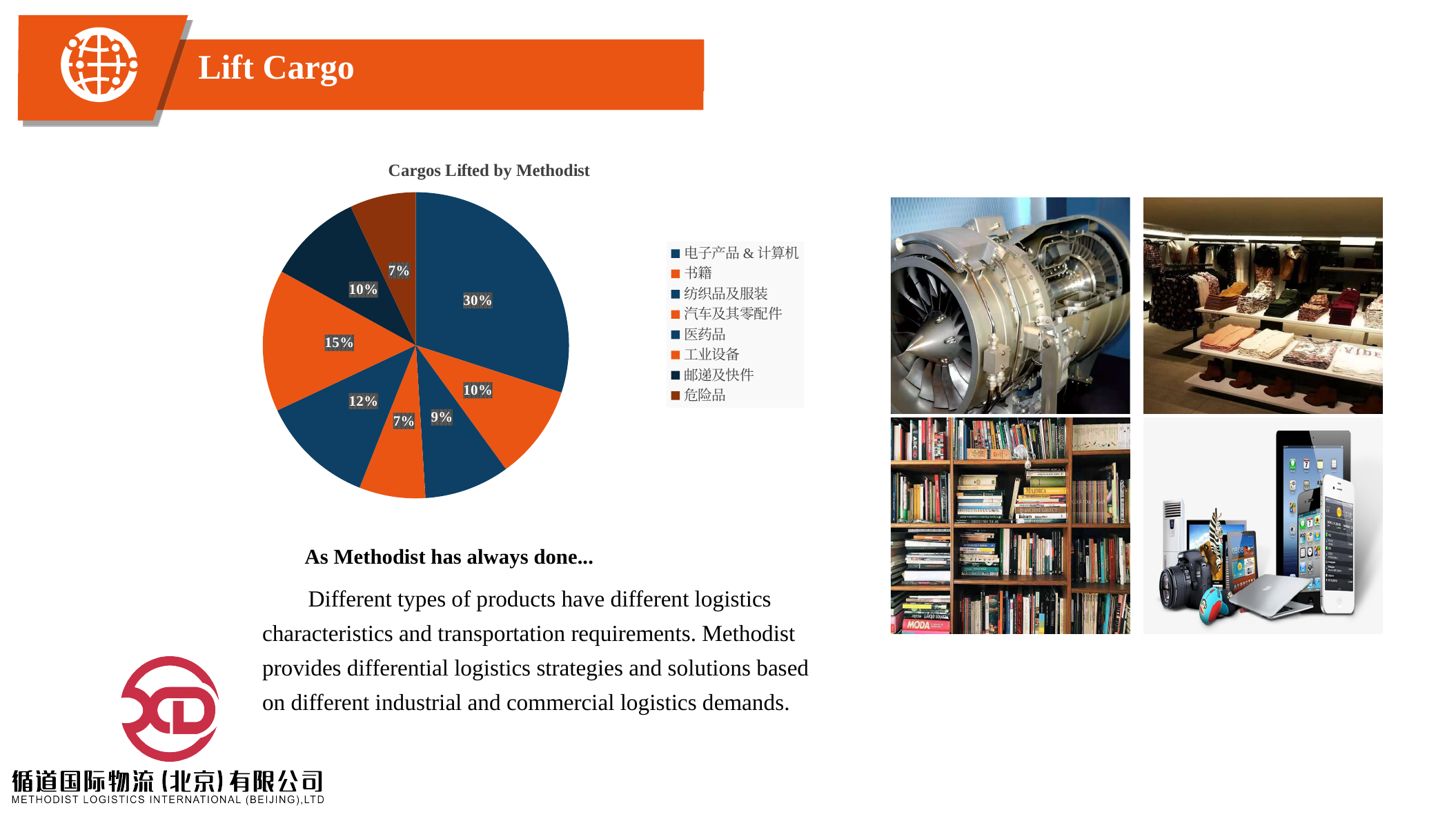
How many entries does the legend list? 8 Which category has the largest share of the pie? 电子产品 & 计算机 What is the value shown for 危险品? 7% What is the title of the chart? Cargos Lifted by Methodist What is the value shown for 工业设备? 15% What is the difference between the shares of 电子产品 & 计算机 and 工业设备? 15% What is the value shown for 医药品? 12% How many slices does the pie chart have? 8 What kind of chart is shown on the slide? pie chart What share of the pie does 电子产品 & 计算机 account for? 30% What is the value shown for 纺织品及服装? 9% Which is larger, the share for 医药品 or the share for 书籍? 医药品